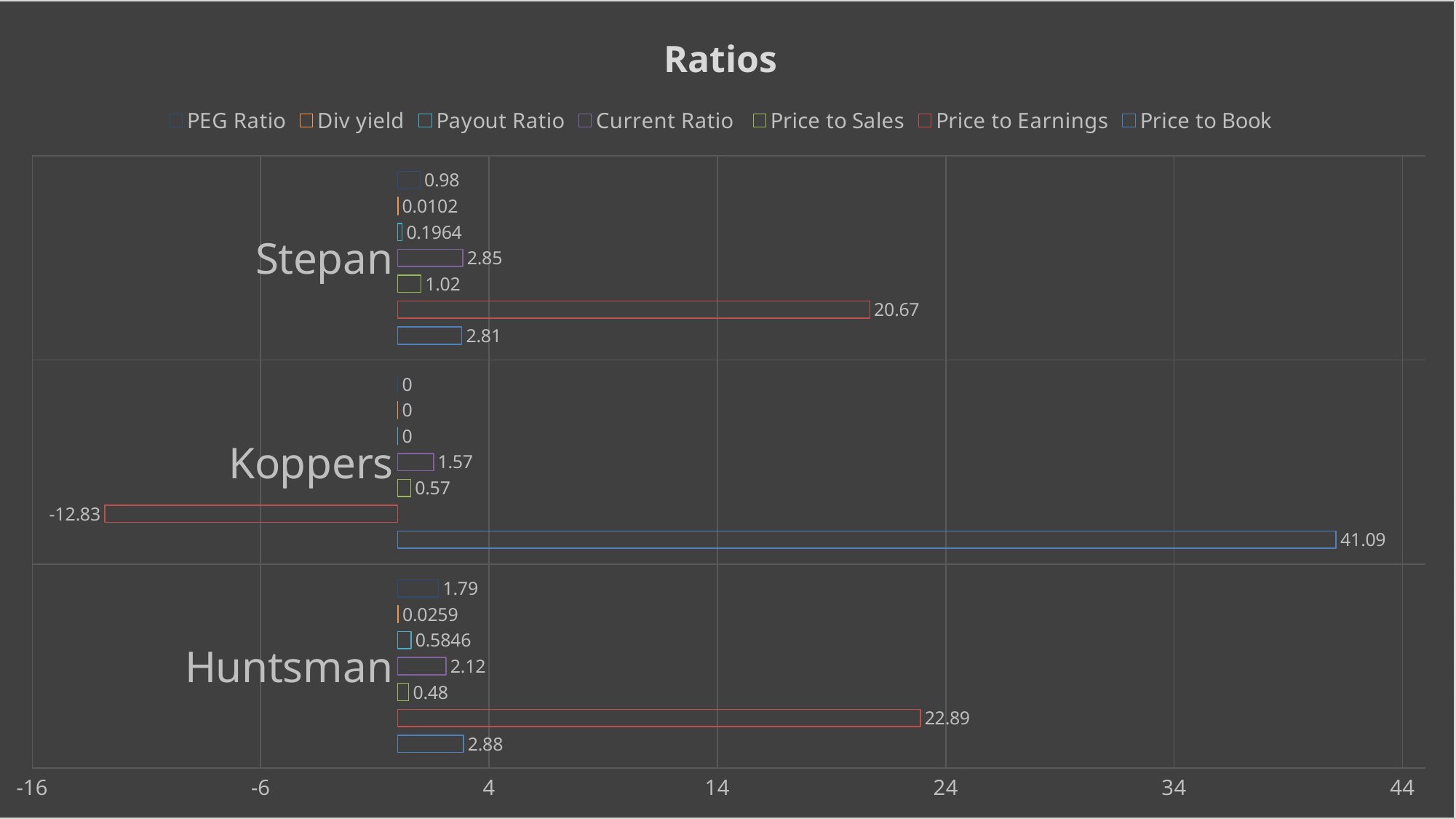
Which company has the lowest Current Ratio? Koppers What is the Price to Earnings value for Koppers? -12.83 How many series does the legend list? 7 What is the difference between the Price to Earnings values of Huntsman and Stepan? 2.22 How many companies are shown on the chart? 3 Which is larger, the Price to Sales value for Stepan or for Huntsman? Stepan What is the Current Ratio for Stepan? 2.85 What is the Price to Earnings value for Stepan? 20.67 Which company has the highest Price to Earnings value? Huntsman What type of chart is shown on the slide? Bar chart What is the Payout Ratio for Huntsman? 0.5846 What is the Price to Book value for Koppers? 41.09